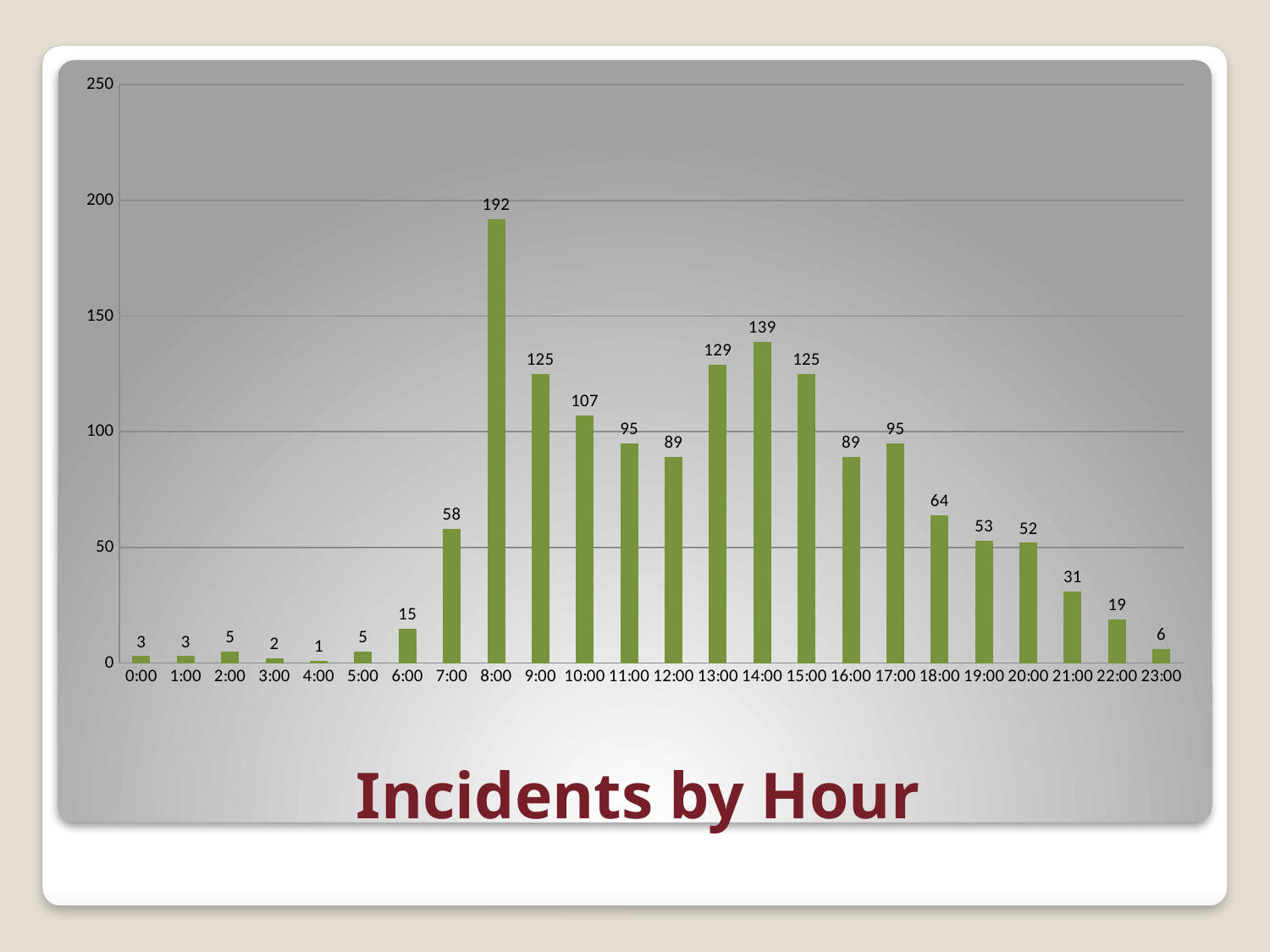
Is the value for 7:00 greater or less than 50? greater What is the value for 8:00? 192 What is the difference between the values for 8:00 and 9:00? 67 What is the title of the chart? Incidents by Hour Which is larger, the value for 10:00 or the value for 17:00? 10:00 What is the value for 14:00? 139 How many hours are shown on the x axis? 24 What is the difference between the values for 13:00 and 12:00? 40 What is the value for 21:00? 31 Which hour has the highest number of incidents? 8:00 What kind of chart is shown on the slide? Bar chart Which hour has the lowest number of incidents? 4:00